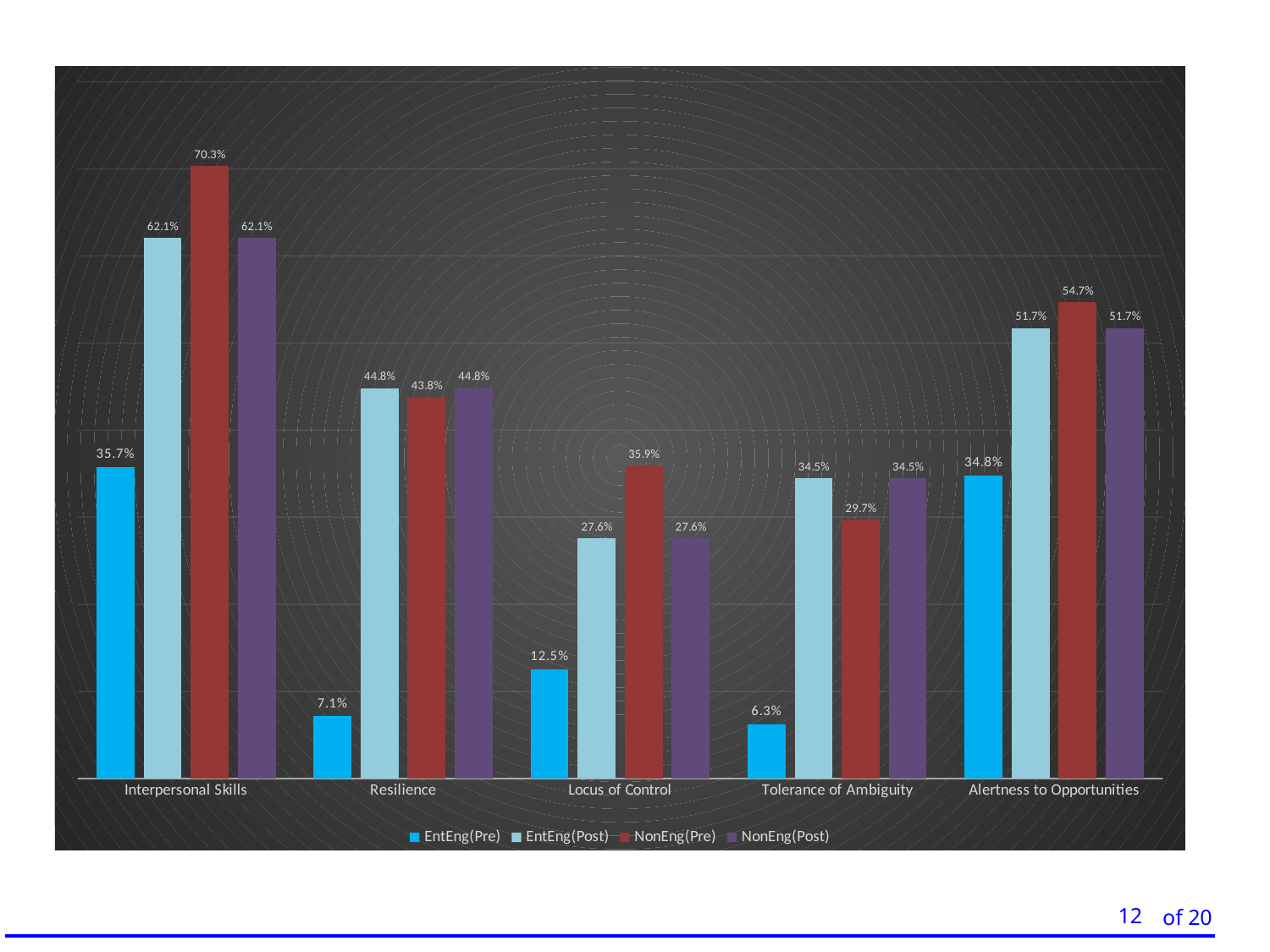
For Locus of Control, which is larger: the NonEng(Pre) value or the NonEng(Post) value? NonEng(Pre) How many categories are shown on the x axis? 5 Which category has the lowest NonEng(Pre) value? Tolerance of Ambiguity What is the NonEng(Pre) value for Interpersonal Skills? 70.3% Which category has the highest EntEng(Pre) value? Interpersonal Skills Which series is shown in dark red in the legend? NonEng(Pre) What is the EntEng(Post) value for Alertness to Opportunities? 51.7% What is the difference between the EntEng(Post) and EntEng(Pre) values for Resilience? 37.7% How many series does the legend list? 4 What kind of chart is shown on the slide? Bar chart What is the difference between the NonEng(Pre) value for Interpersonal Skills and the NonEng(Pre) value for Alertness to Opportunities? 15.6% What is the EntEng(Pre) value for Tolerance of Ambiguity? 6.3%